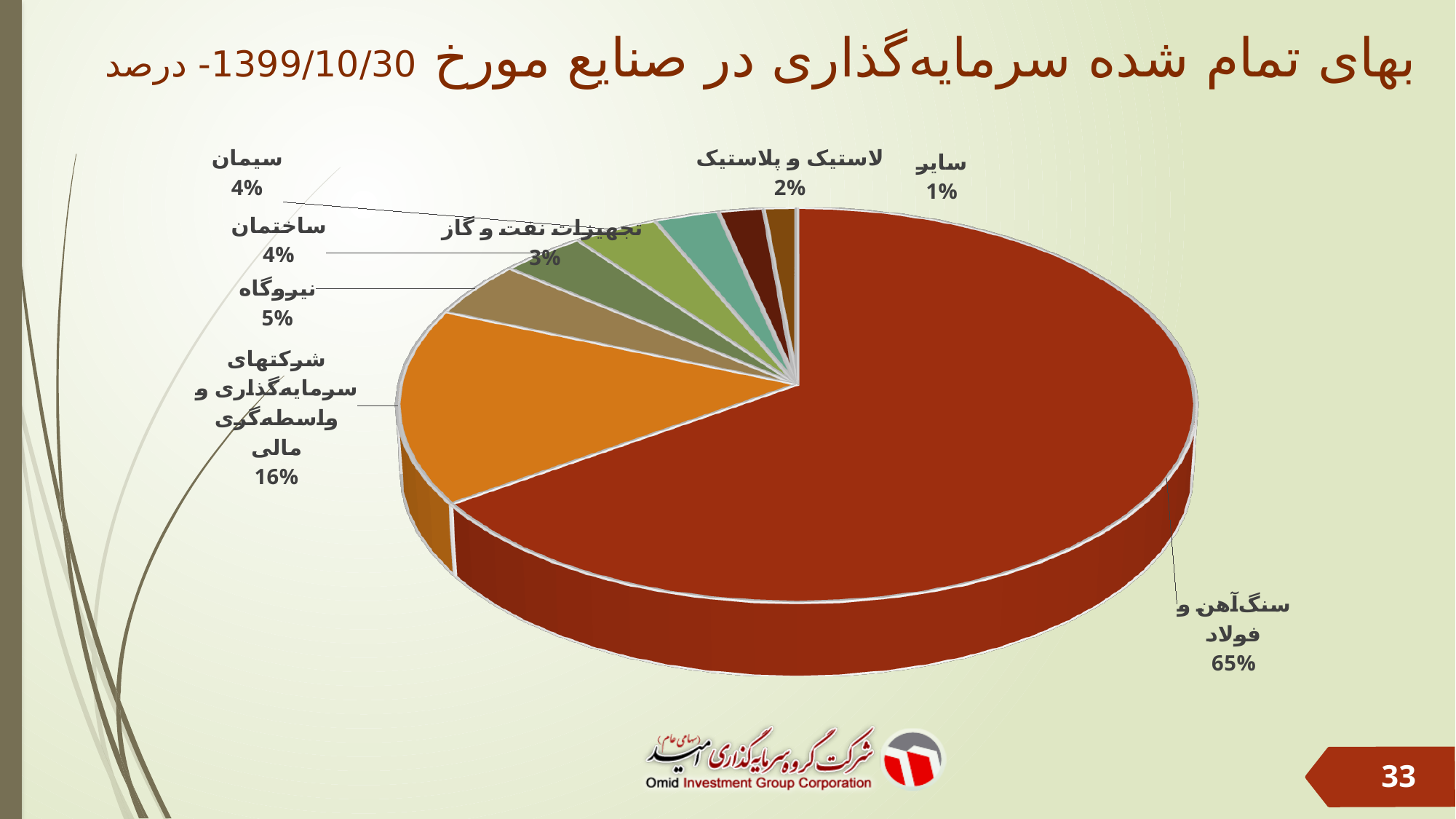
What percentage does the سنگ‌آهن و فولاد slice represent? 65% What kind of chart is shown on the slide? pie chart What percentage is shown for تجهیزات نفت و گاز? 3% Which is larger, the share for نیروگاه or the share for لاستیک و پلاستیک? نیروگاه What percentage do سیمان and ساختمان each represent? 4% Which category has the smallest share of the pie? سایر What is the difference in percentage points between سنگ‌آهن و فولاد and شرکتهای سرمایه‌گذاری و واسطه‌گری مالی? 49 What percentage is shown for شرکتهای سرمایه‌گذاری و واسطه‌گری مالی? 16% What date is given in the chart title? 1399/10/30 What is the value labelled for نیروگاه? 5% Which category has the largest share of the pie? سنگ‌آهن و فولاد How many slices does the pie chart have? 8